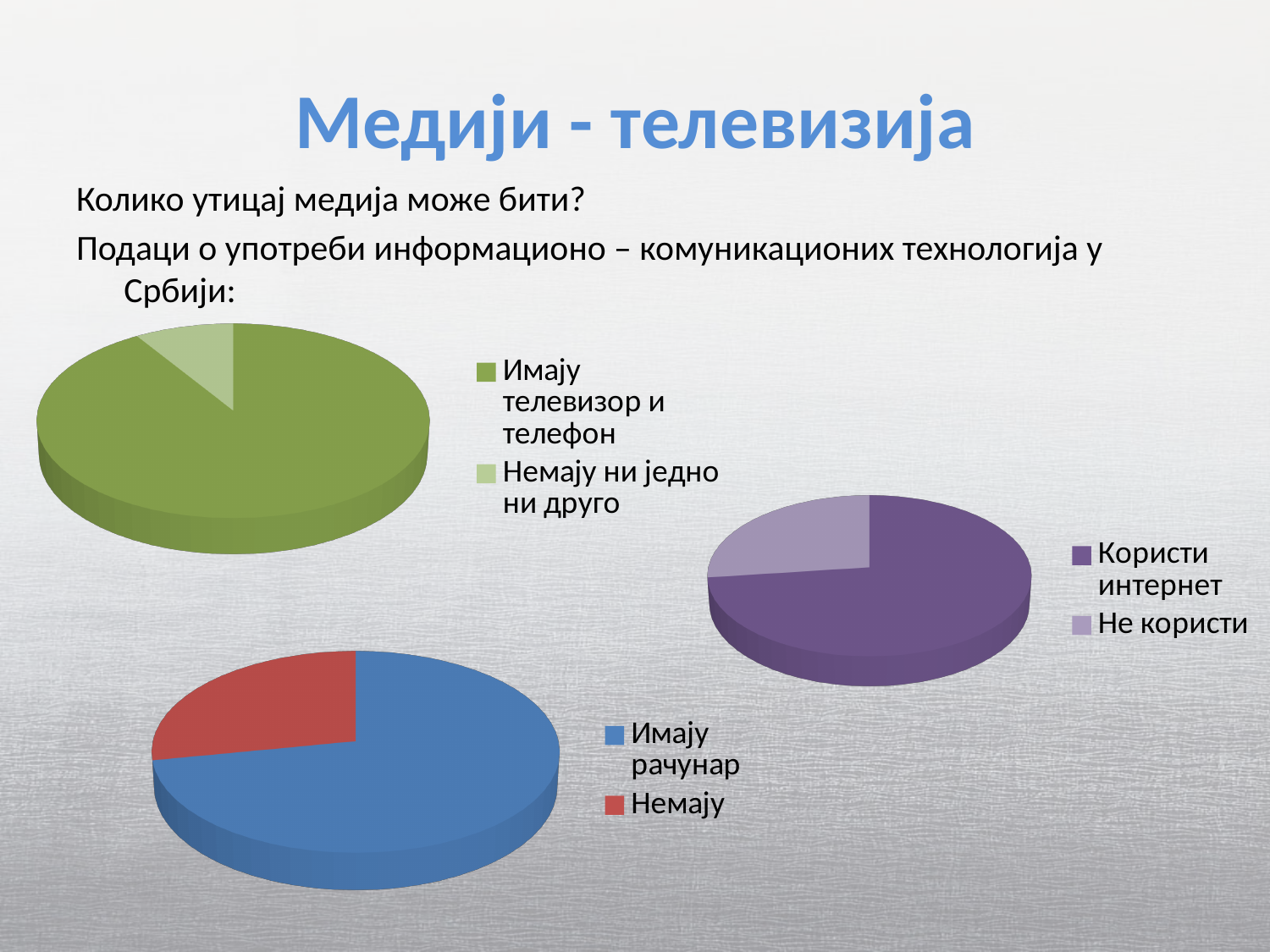
What kind of chart is the purple chart on the right of the slide? pie chart In the green pie chart at the top left, which category has the smallest slice? Немају ни једно ни друго In the purple pie chart on the right, which category has the largest slice? Користи интернет What kind of chart is the green chart at the top left of the slide? pie chart In the blue and red pie chart at the bottom left, which slice is larger, Имају рачунар or Немају? Имају рачунар How many categories does the legend of the purple pie chart on the right list? 2 In the blue and red pie chart at the bottom left, which category has the largest slice? Имају рачунар In the purple pie chart on the right, which category has the smallest slice? Не користи In the green pie chart at the top left, which category has the largest slice? Имају телевизор и телефон How many categories does the legend of the green pie chart at the top left list? 2 In the blue and red pie chart at the bottom left, what colour is the slice for Немају? red What kind of chart is the blue and red chart at the bottom left of the slide? pie chart